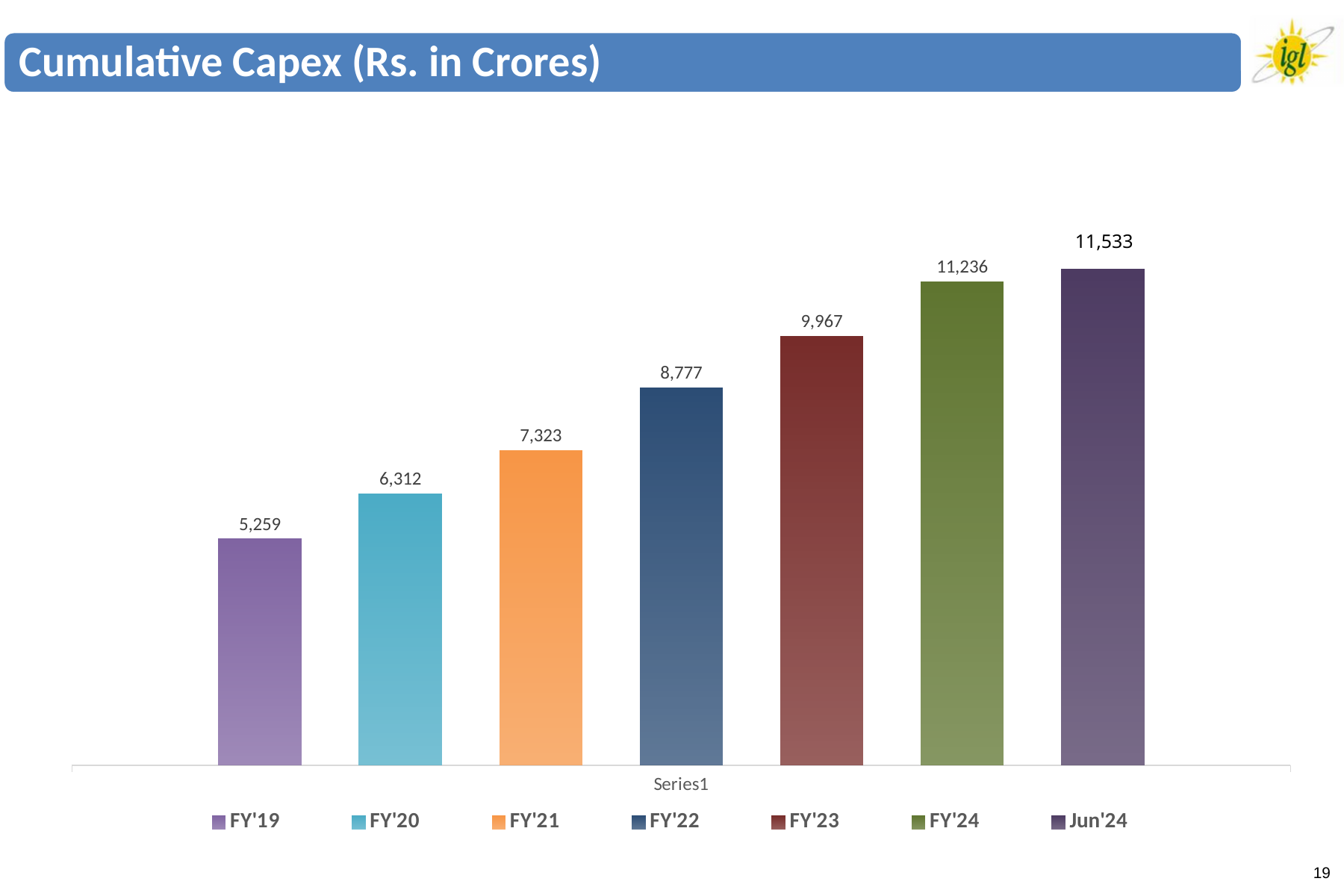
What is the cumulative capex value for Jun'24? 11,533 What kind of chart is shown on the slide? Bar chart Which period has the highest cumulative capex? Jun'24 How many entries does the legend list? 7 Which period has the lowest cumulative capex? FY'19 How many bars are shown in the chart? 7 Do the cumulative capex values rise or fall from FY'19 to Jun'24? Rise What is the cumulative capex value for FY'19? 5,259 What is the difference between the cumulative capex for Jun'24 and FY'19? 6,274 Which is larger, the cumulative capex for FY'21 or FY'20? FY'21 What is the cumulative capex value for FY'22? 8,777 What is the difference between the cumulative capex for FY'24 and FY'23? 1,269